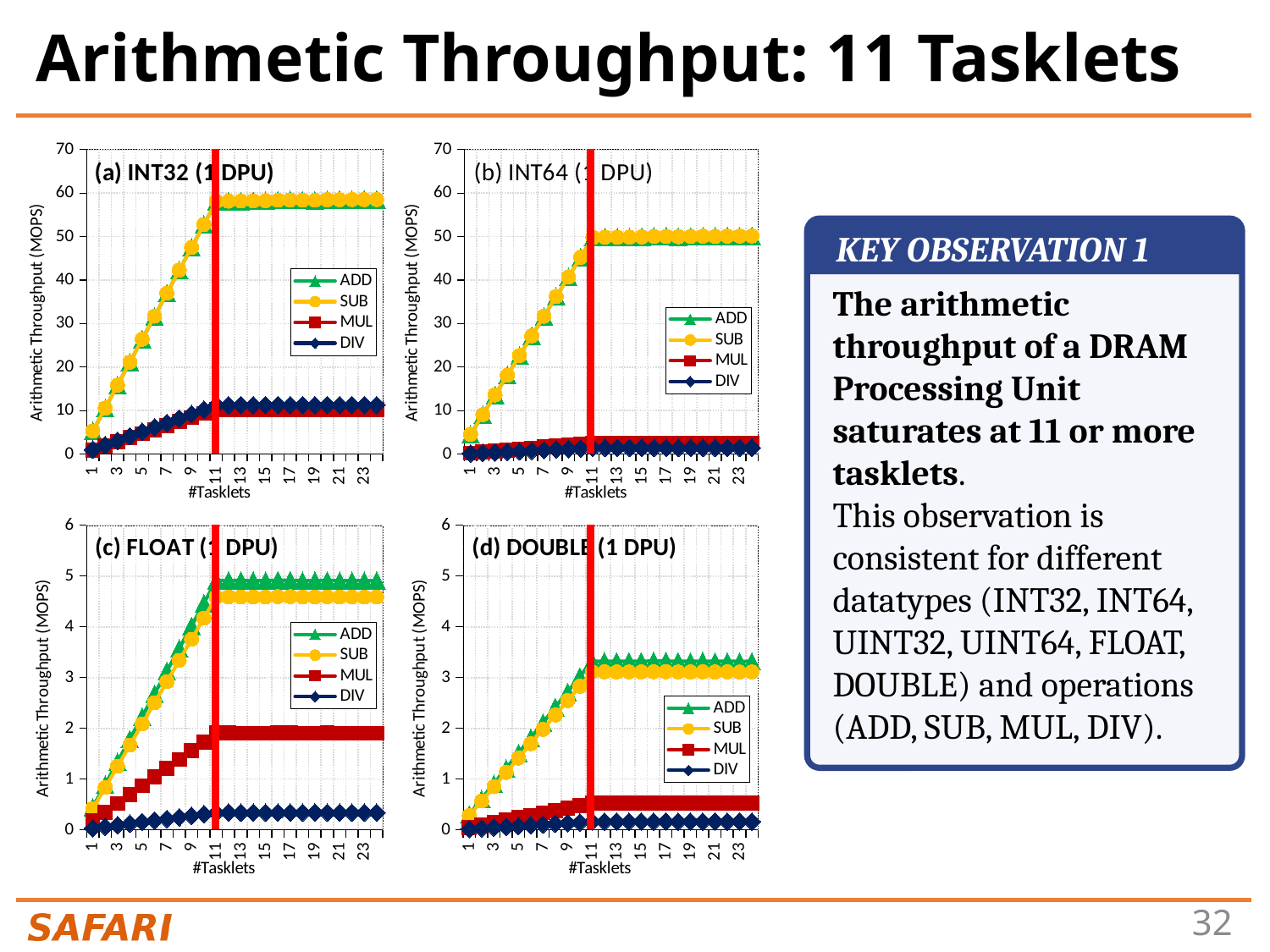
At what number of tasklets is the red vertical line drawn in each chart? 11 What kind of chart is chart (a) INT32 (1 DPU)? line chart In chart (b) INT64 (1 DPU), is the DIV value at 23 tasklets greater or less than 10? less In chart (d) DOUBLE (1 DPU), is the ADD value at 23 tasklets greater or less than 3? greater In chart (a) INT32 (1 DPU), is the ADD value at 23 tasklets greater or less than 50? greater How many series does the legend of chart (b) INT64 (1 DPU) list? 4 How many charts are shown on the slide? 4 In chart (c) FLOAT (1 DPU), which is larger at 23 tasklets, MUL or DIV? MUL In chart (c) FLOAT (1 DPU), which series has the lowest throughput at 23 tasklets? DIV In chart (a) INT32 (1 DPU), does the ADD throughput rise or fall as the number of tasklets increases from 1 to 11? rise